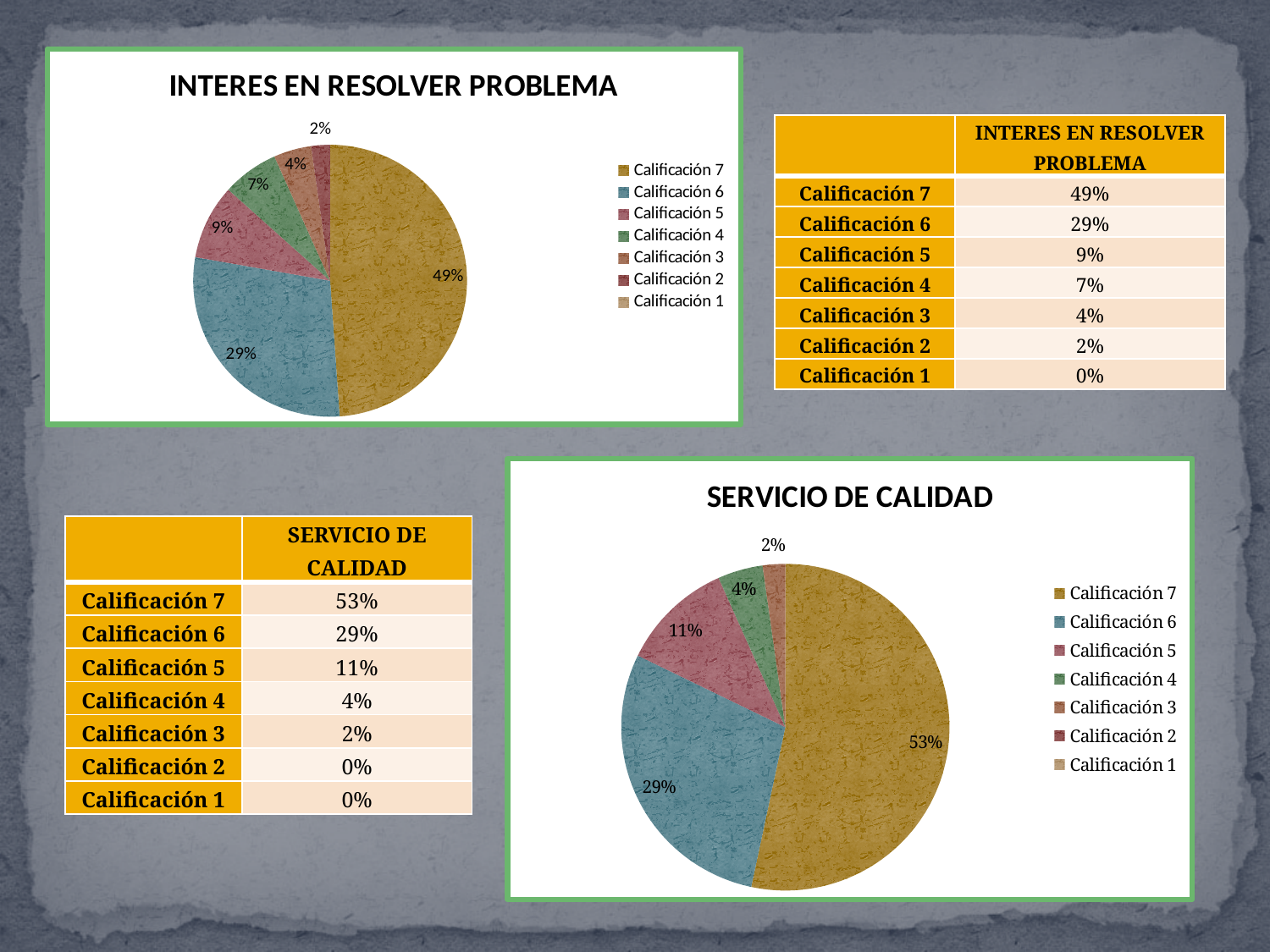
In the INTERES EN RESOLVER PROBLEMA chart, which is larger, the share of Calificación 4 or Calificación 3? Calificación 4 In the SERVICIO DE CALIDAD chart, what is the difference between the shares of Calificación 6 and Calificación 5? 18% In the INTERES EN RESOLVER PROBLEMA chart, what is the difference between the shares of Calificación 7 and Calificación 6? 20% How many entries does the legend of the SERVICIO DE CALIDAD chart list? 7 In the INTERES EN RESOLVER PROBLEMA chart, which category has the largest slice? Calificación 7 In the SERVICIO DE CALIDAD chart, what share does Calificación 7 have? 53% In the INTERES EN RESOLVER PROBLEMA chart, what share does Calificación 7 have? 49% What is the title of the chart in the top-left of the slide? INTERES EN RESOLVER PROBLEMA In the INTERES EN RESOLVER PROBLEMA chart, what share does Calificación 5 have? 9% What kind of chart is the SERVICIO DE CALIDAD chart? Pie chart In the SERVICIO DE CALIDAD chart, which is larger, the share of Calificación 6 or Calificación 5? Calificación 6 In the SERVICIO DE CALIDAD chart, what share does Calificación 5 have? 11%